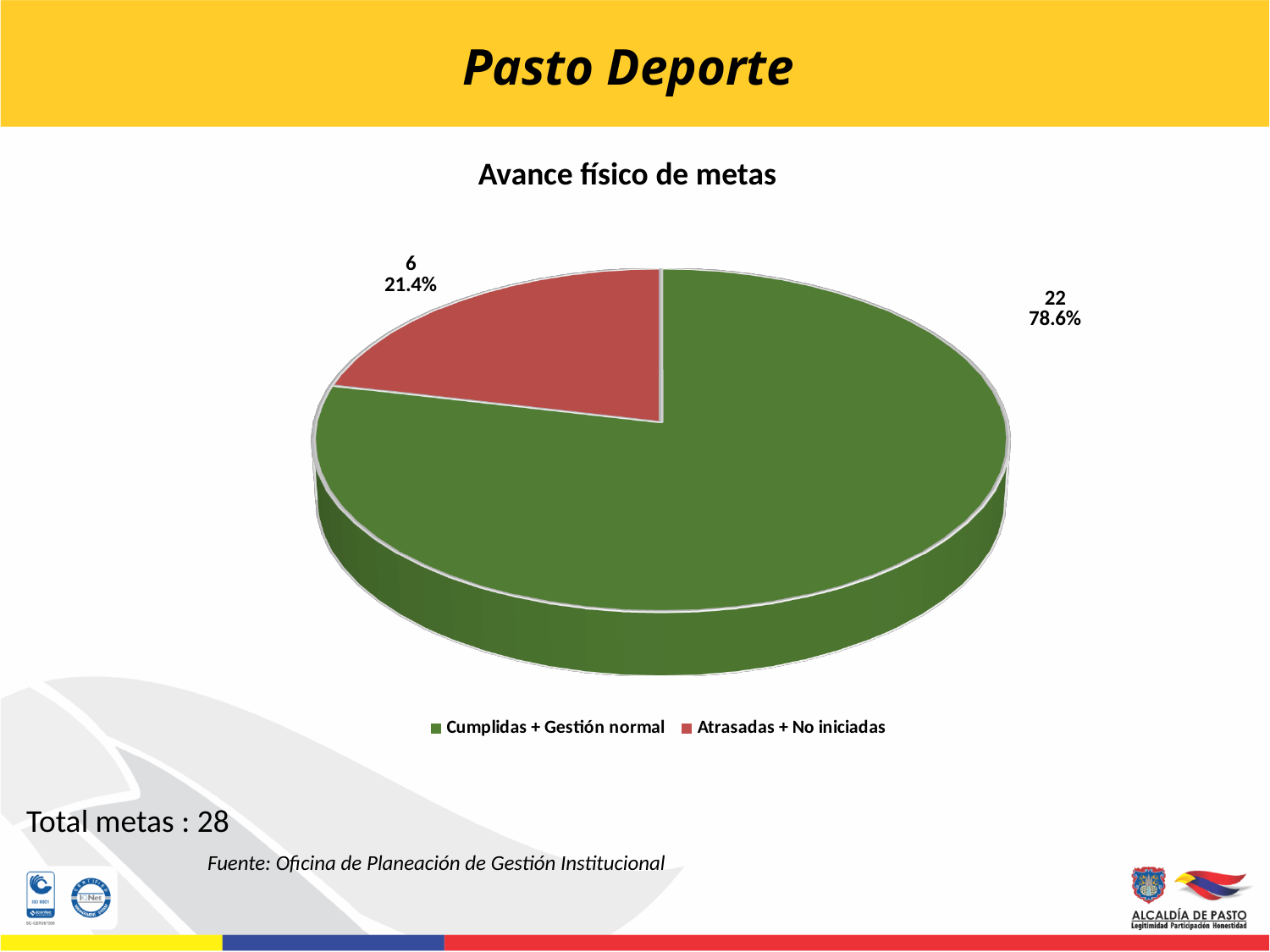
How many slices does the pie chart have? 2 What is the title of the chart? Avance físico de metas What is the difference between the values for 'Cumplidas + Gestión normal' and 'Atrasadas + No iniciadas'? 16 Which category has the largest slice? Cumplidas + Gestión normal What share of the pie does 'Atrasadas + No iniciadas' represent? 21.4% How many entries does the legend list? 2 What share of the pie does 'Cumplidas + Gestión normal' represent? 78.6% Which category has the smallest slice? Atrasadas + No iniciadas What is the value for 'Cumplidas + Gestión normal'? 22 Which colour represents 'Atrasadas + No iniciadas' in the chart? Red What kind of chart is shown on the slide? Pie chart What is the value for 'Atrasadas + No iniciadas'? 6